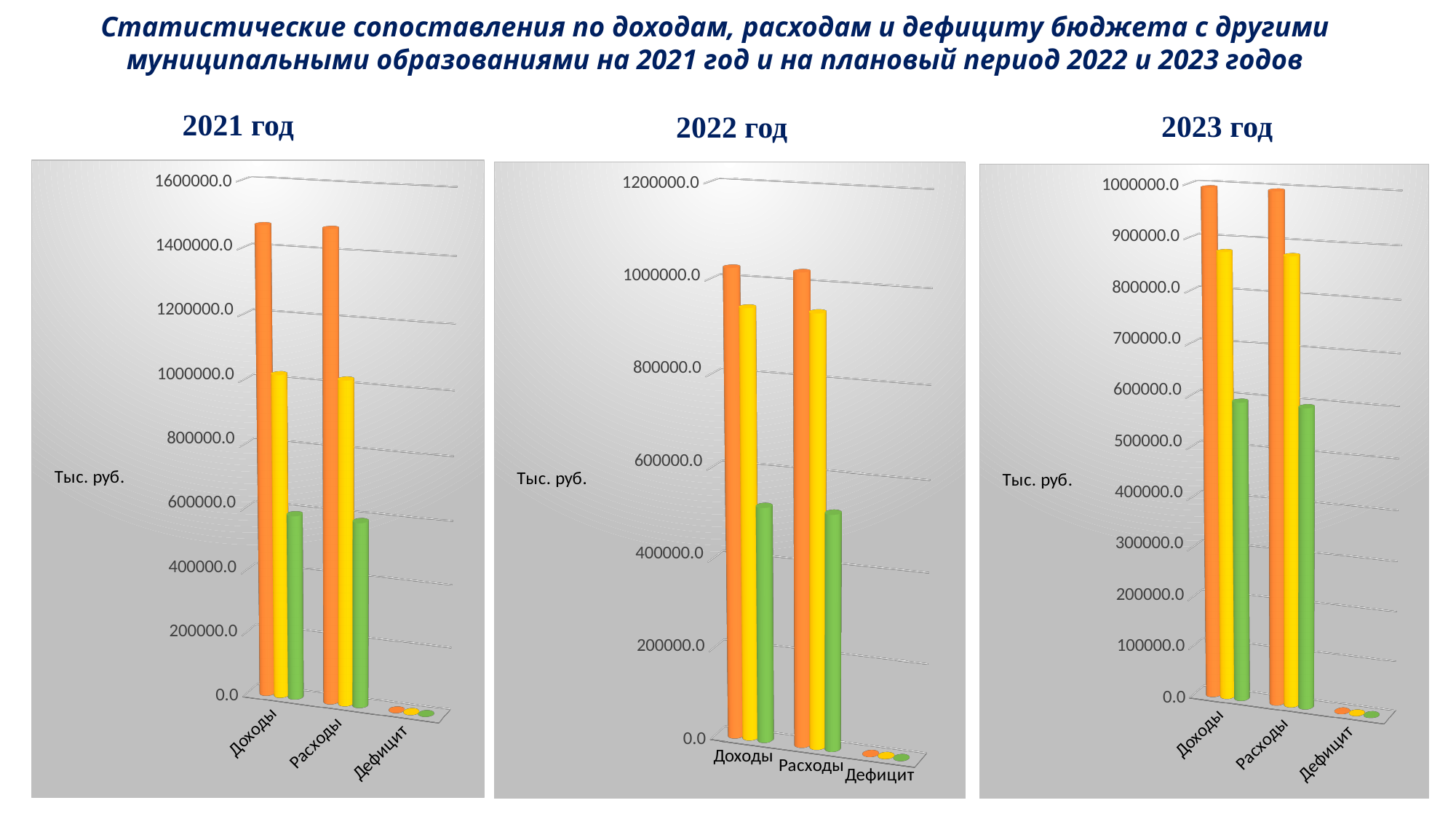
In the 2022 год chart, is the orange bar for Доходы greater or less than 800000.0? greater In the 2023 год chart, is the green bar for Доходы greater or less than 500000.0? greater What unit label is shown on the vertical axis of the 2022 год chart? Тыс. руб. In the 2023 год chart, which category has the lowest bars? Дефицит In the 2021 год chart, which is larger for Доходы: the orange bar or the green bar? the orange bar In the 2021 год chart, how many bars are shown for the Доходы category? 3 In the 2023 год chart, is the yellow bar for Доходы greater or less than 800000.0? greater What kind of chart is the 2021 год chart? bar chart How many categories are shown on the x axis of the 2022 год chart? 3